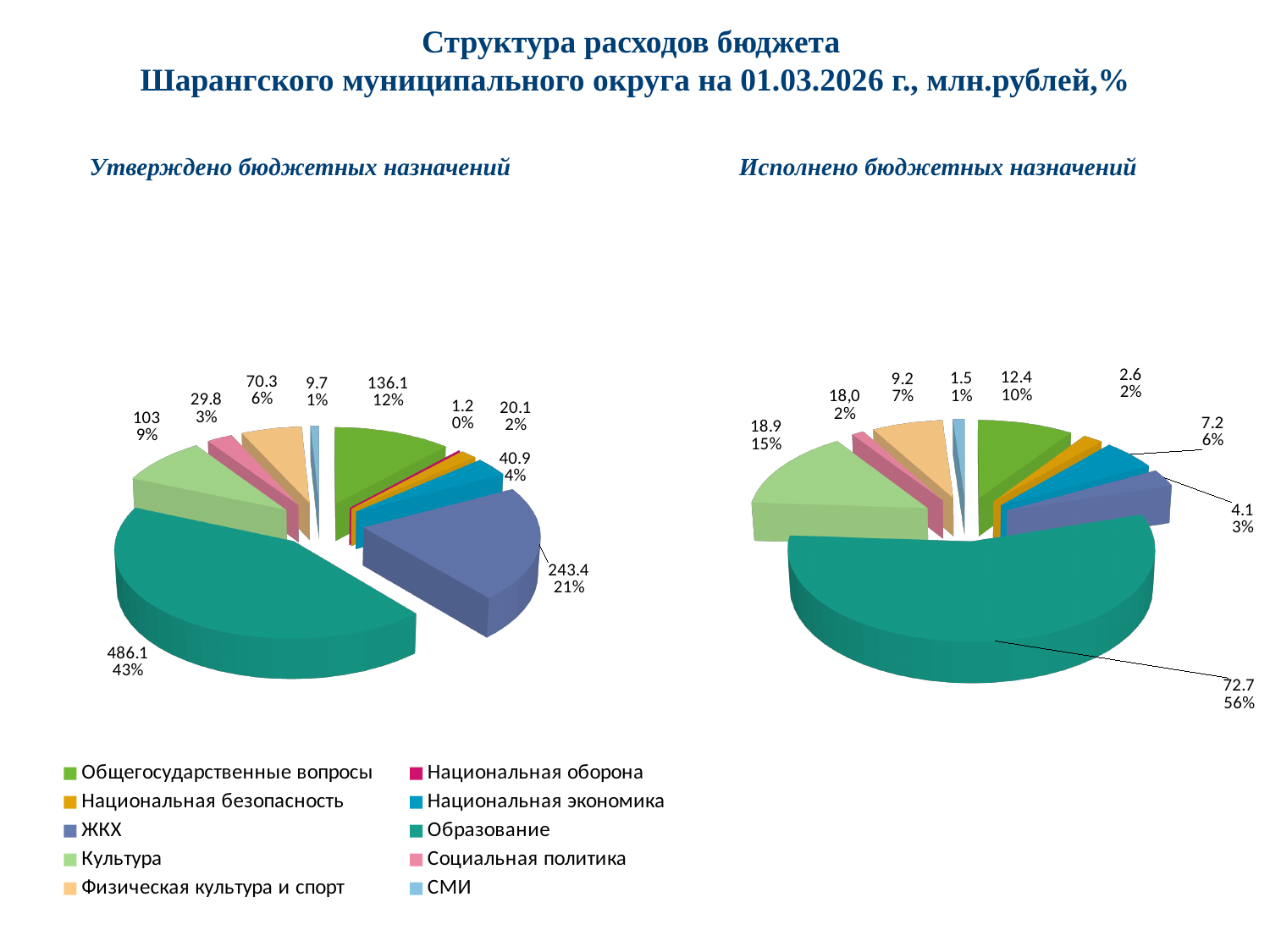
What kind of charts are shown on the slide? Pie charts How many categories does the legend list? 10 In the chart 'Утверждено бюджетных назначений', what share of the pie does ЖКХ take? 21% In the chart 'Исполнено бюджетных назначений', what is the value for Физическая культура и спорт? 9.2 In the chart 'Утверждено бюджетных назначений', which category has the largest slice? Образование In the chart 'Утверждено бюджетных назначений', which category has the smallest slice? Национальная оборона In the chart 'Утверждено бюджетных назначений', what is the difference between the values for Образование and ЖКХ? 242.7 In the chart 'Утверждено бюджетных назначений', what is the value for Культура? 103 In the chart 'Исполнено бюджетных назначений', what share of the pie does Культура take? 15% In the chart 'Утверждено бюджетных назначений', what is the value for Образование? 486.1 In the chart 'Исполнено бюджетных назначений', which is larger, the value for Национальная экономика or the value for ЖКХ? Национальная экономика In the chart 'Исполнено бюджетных назначений', what is the value for Образование? 72.7